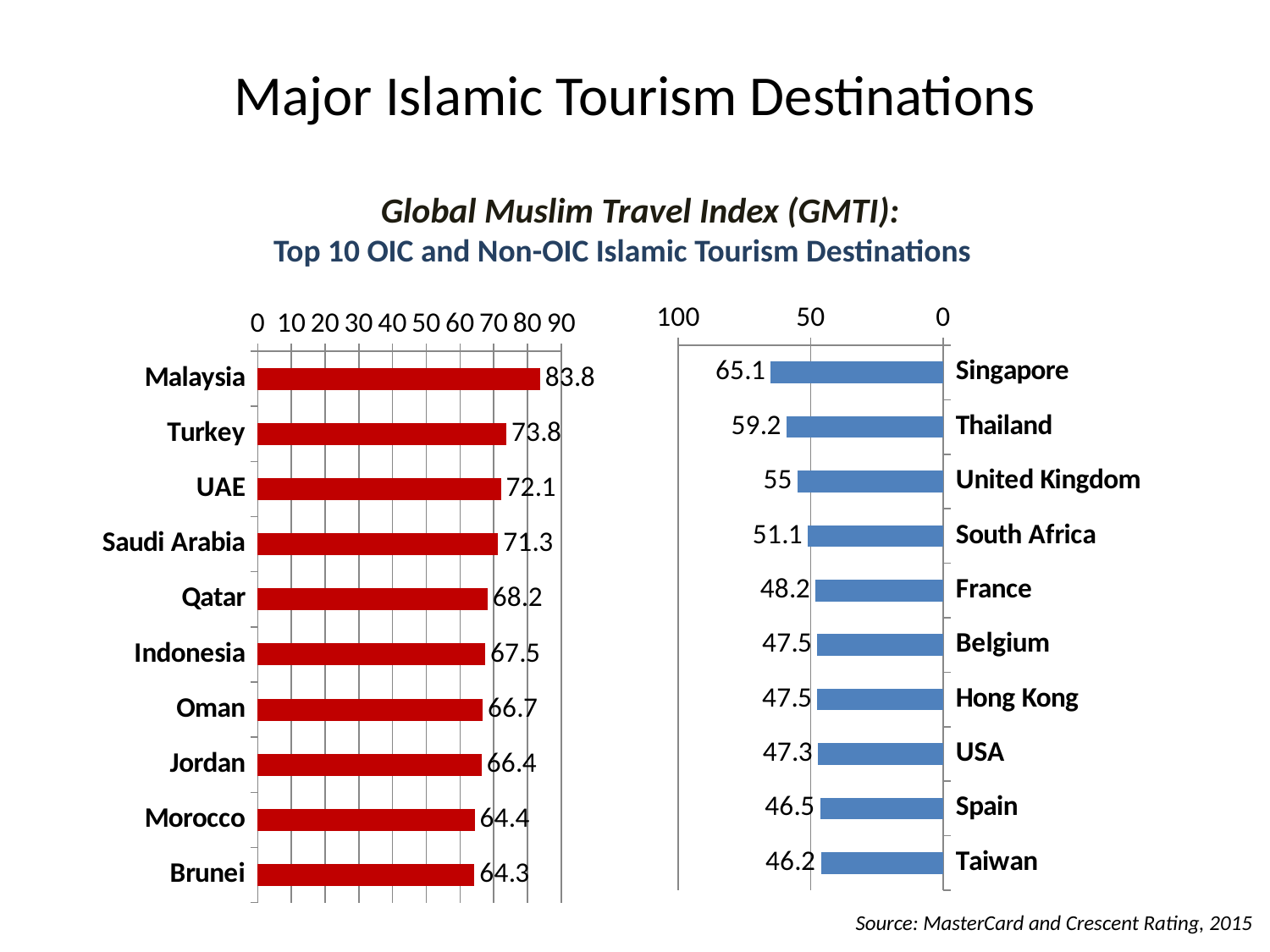
In the right chart, what is the difference between the values for Singapore and Thailand? 5.9 In the left chart, what is the difference between the values for Malaysia and Turkey? 10 How many countries are shown in the left chart? 10 In the right chart, what is the value for United Kingdom? 55 In the right chart, is the value for France greater or less than 50? less What kind of chart is the right chart? bar chart In the left chart, which country has the highest value? Malaysia In the left chart, what is the value for Malaysia? 83.8 In the right chart, which country has the lowest value? Taiwan In the left chart, which is larger, the value for Qatar or the value for Oman? Qatar What colour are the bars in the right chart? blue In the left chart, what is the value for Brunei? 64.3